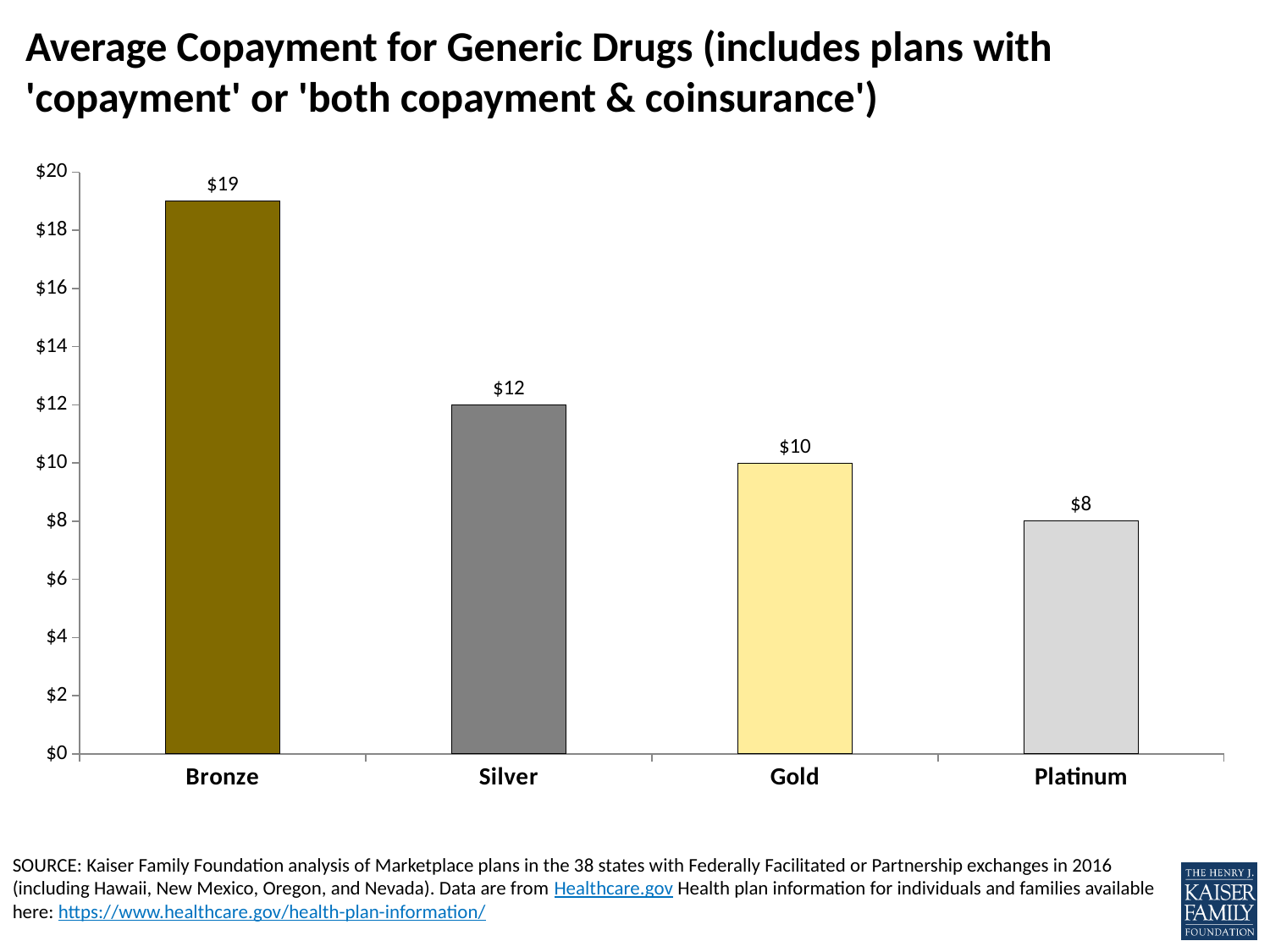
What is the average copayment for generic drugs for Platinum plans? $8 What is the difference between the average copayment for Silver and Gold plans? $2 Do the average copayment values rise or fall moving from Bronze to Platinum along the x axis? Fall What is the average copayment for generic drugs for Bronze plans? $19 Which has a larger average copayment for generic drugs, Silver or Gold? Silver Which plan tier has the lowest average copayment for generic drugs? Platinum What is the average copayment for generic drugs for Silver plans? $12 How much higher is the average copayment for Bronze plans than for Platinum plans? $11 How many plan tiers are shown in the chart? 4 Which plan tier has the highest average copayment for generic drugs? Bronze What is the average copayment for generic drugs for Gold plans? $10 What kind of chart is shown on the slide? Bar chart